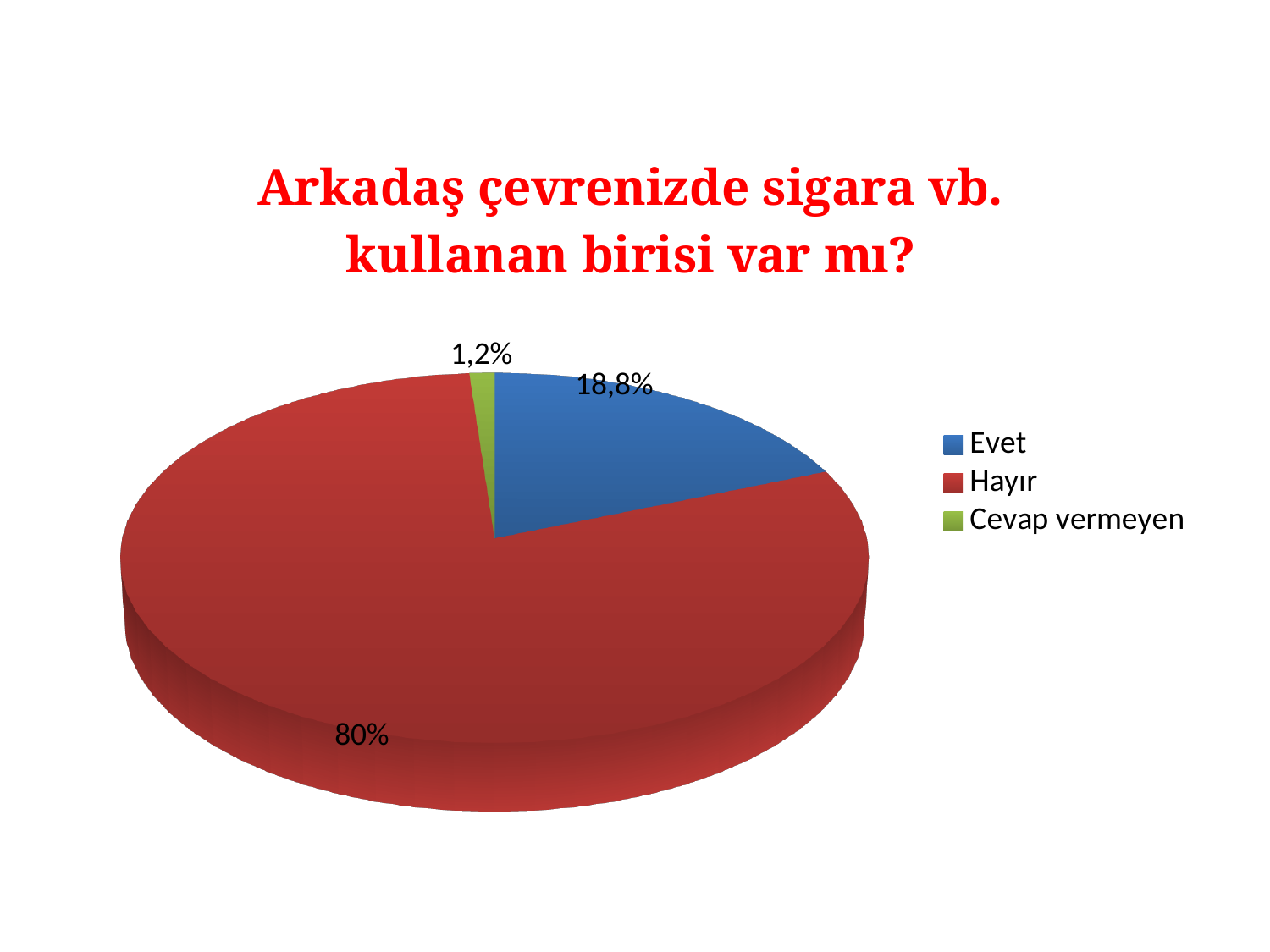
What is the value for Hayır? 80% Which category has the largest slice? Hayır Which is larger, Evet or Cevap vermeyen? Evet What type of chart is shown on the slide? pie chart Which category has the smallest slice? Cevap vermeyen What is the value for Cevap vermeyen? 1,2% What is the difference between the values for Evet and Cevap vermeyen? 17,6% What is the title of the chart? Arkadaş çevrenizde sigara vb. kullanan birisi var mı? Which colour represents Hayır in the legend? red What is the value for Evet? 18,8% What is the difference between the values for Hayır and Evet? 61,2% How many categories does the pie chart have? 3